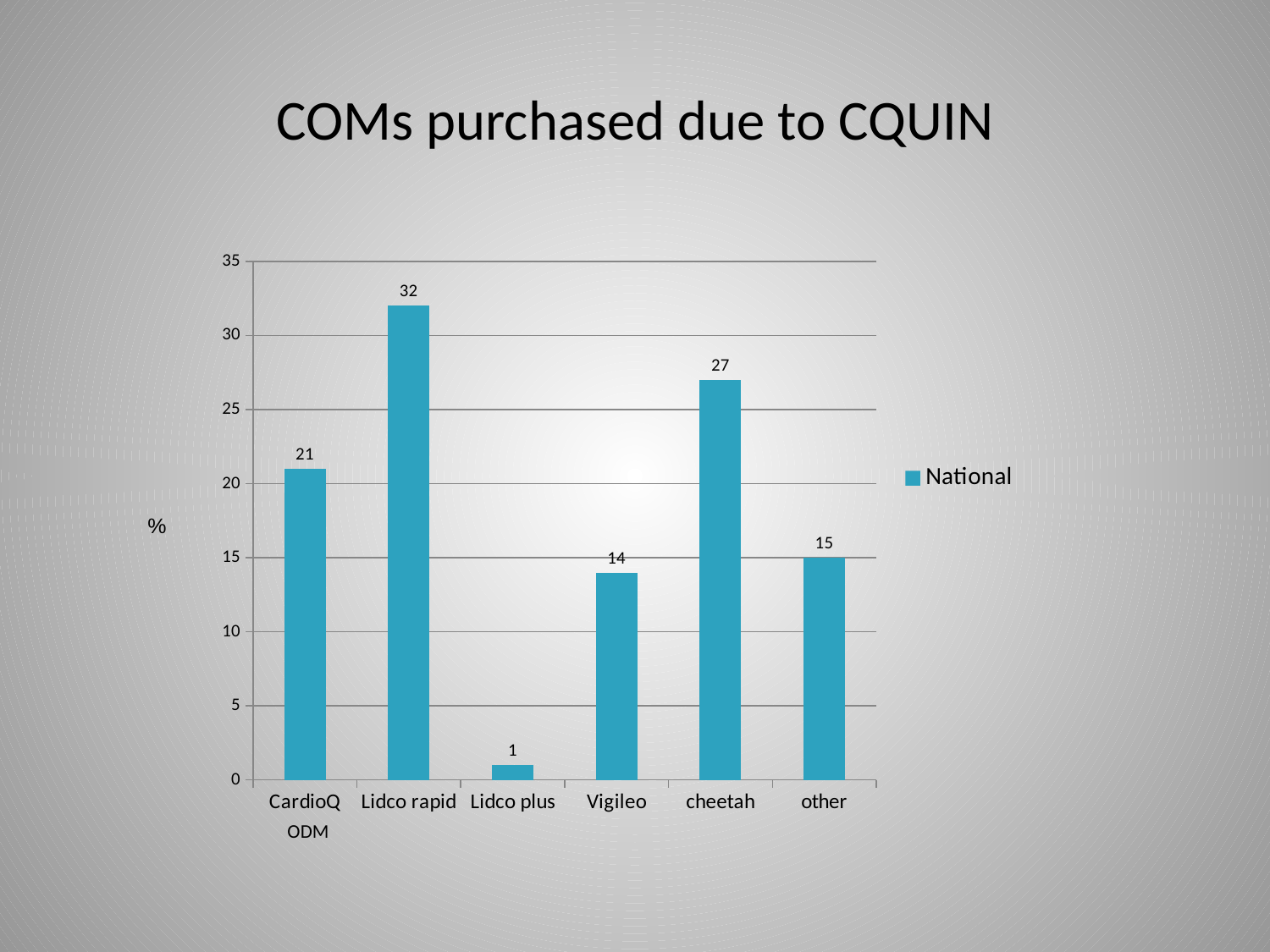
Which is larger, the value for Vigileo or the value for other? other Which category has the highest value? Lidco rapid What is the value for Lidco rapid? 32 What is the value for CardioQ ODM? 21 What kind of chart is shown on the slide? bar chart What is the difference between the values for Lidco rapid and cheetah? 5 What is the title of the chart? COMs purchased due to CQUIN What is the value for cheetah? 27 How many series does the legend list? 1 Is the value for CardioQ ODM greater or less than 20? greater How many categories are shown on the x axis? 6 Which category has the lowest value? Lidco plus